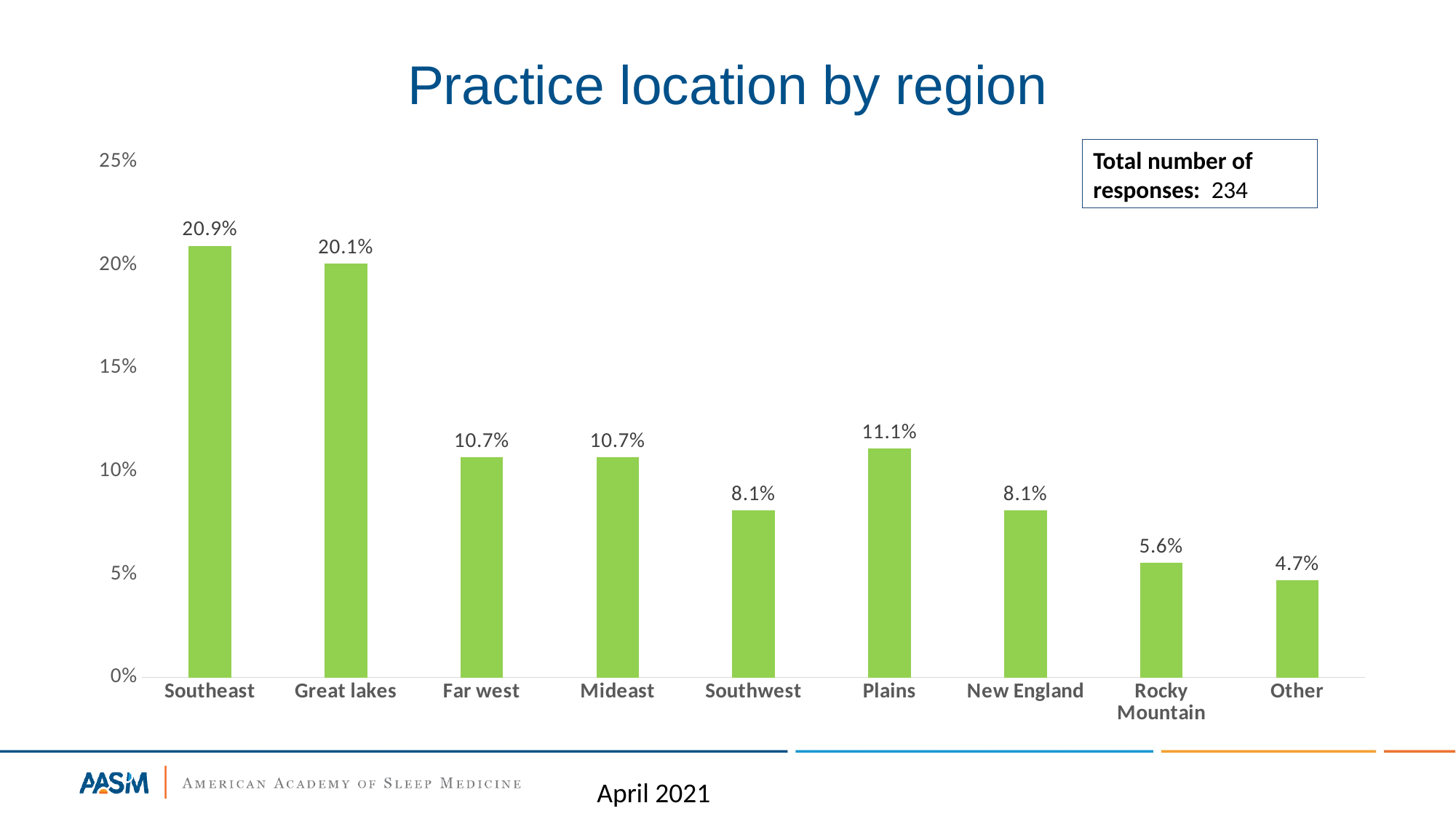
What kind of chart is shown on the slide? bar chart How many regions are shown on the x axis? 9 What is the total number of responses stated on the slide? 234 What is the difference between the Southeast and Great lakes percentages? 0.8% Which category has the lowest percentage? Other Which is larger, the value for Plains or the value for Far west? Plains What is the value shown for the Plains region? 11.1% What percentage of respondents practice in the Southeast region? 20.9% Is the value for Southwest greater or less than 10%? less What percentage is shown for Rocky Mountain? 5.6% What is the difference between the Plains and New England values? 3.0% Which region has the highest percentage? Southeast